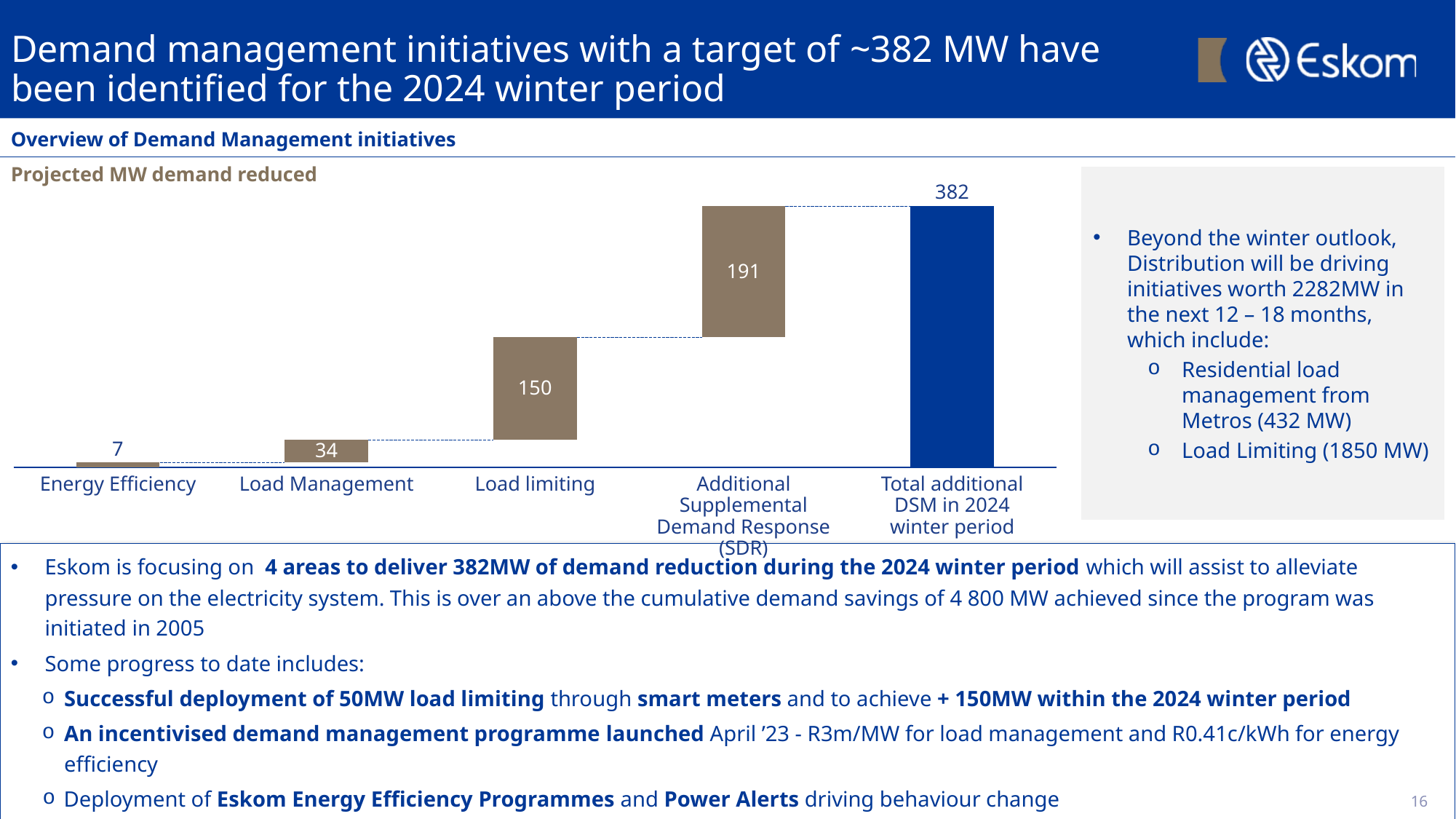
What is the difference between the values for Additional Supplemental Demand Response (SDR) and Load limiting? 41 What is the difference between the values for Load limiting and Load Management? 116 Which is larger, the value for Load Management or the value for Energy Efficiency? Load Management What is the value of the Total additional DSM in 2024 winter period bar? 382 What value is shown for Energy Efficiency? 7 How many categories are shown on the x axis of the chart? 5 What value is shown for Additional Supplemental Demand Response (SDR)? 191 Which of the four individual initiatives has the highest projected MW demand reduced? Additional Supplemental Demand Response (SDR) Do the values of the four individual initiatives rise or fall from left to right along the x axis? rise Which category has the lowest value in the chart? Energy Efficiency What is the projected MW demand reduced for Load limiting? 150 What kind of chart is shown on the slide? bar chart